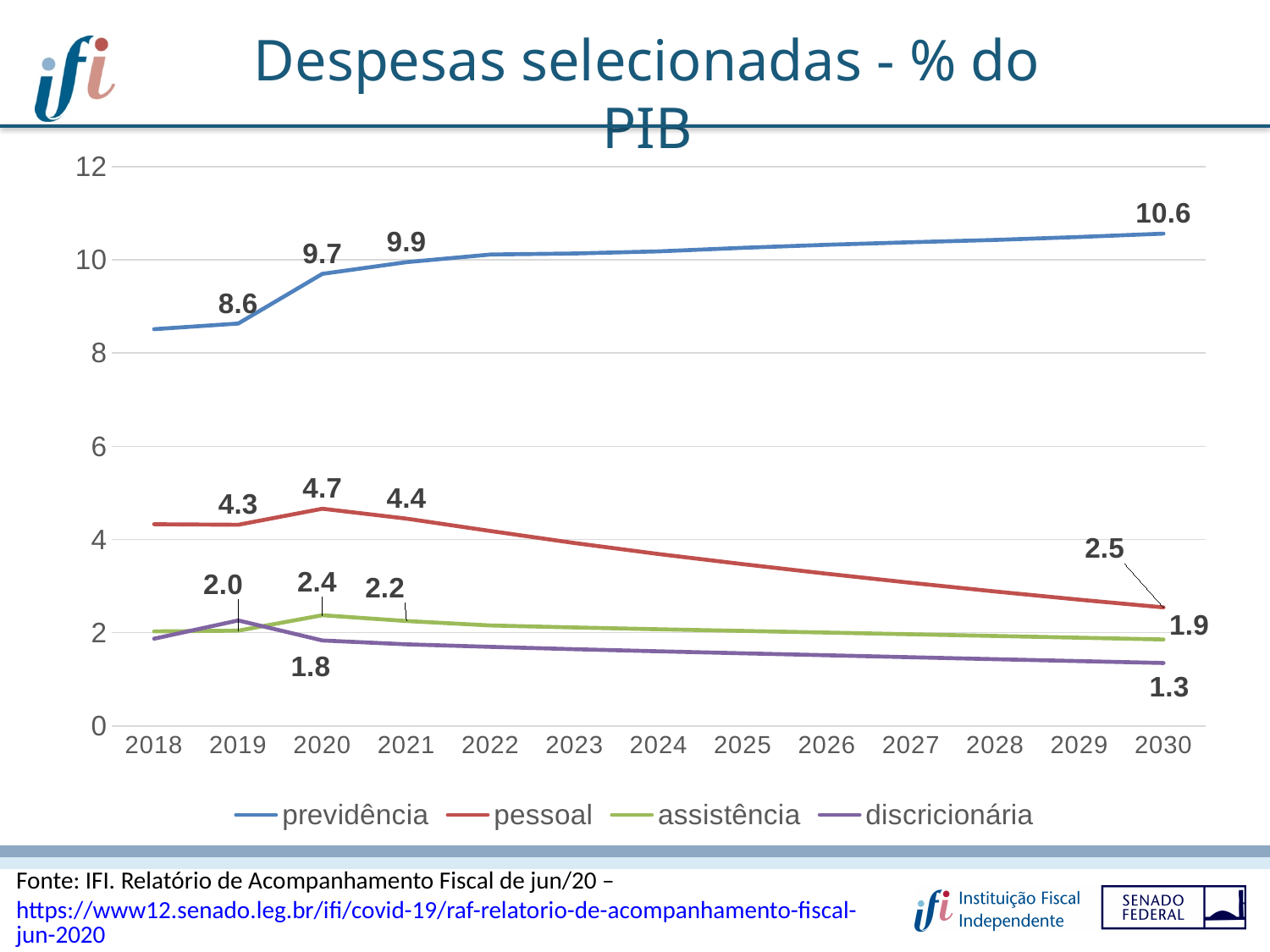
By how much does previdência increase from 2019 to 2030? 2.0 What is the difference between pessoal in 2020 and pessoal in 2030? 2.2 Does the pessoal line rise or fall from 2020 to 2030? fall Which series has the highest value in 2030? previdência What is the value for previdência in 2030? 10.6 What is the value for assistência in 2030? 1.9 What is the value for pessoal in 2020? 4.7 What is the value for discricionária in 2030? 1.3 What kind of chart is shown on the slide? line chart How many series does the legend list? 4 Which is larger in 2021, pessoal or assistência? pessoal How many years are shown on the x axis? 13